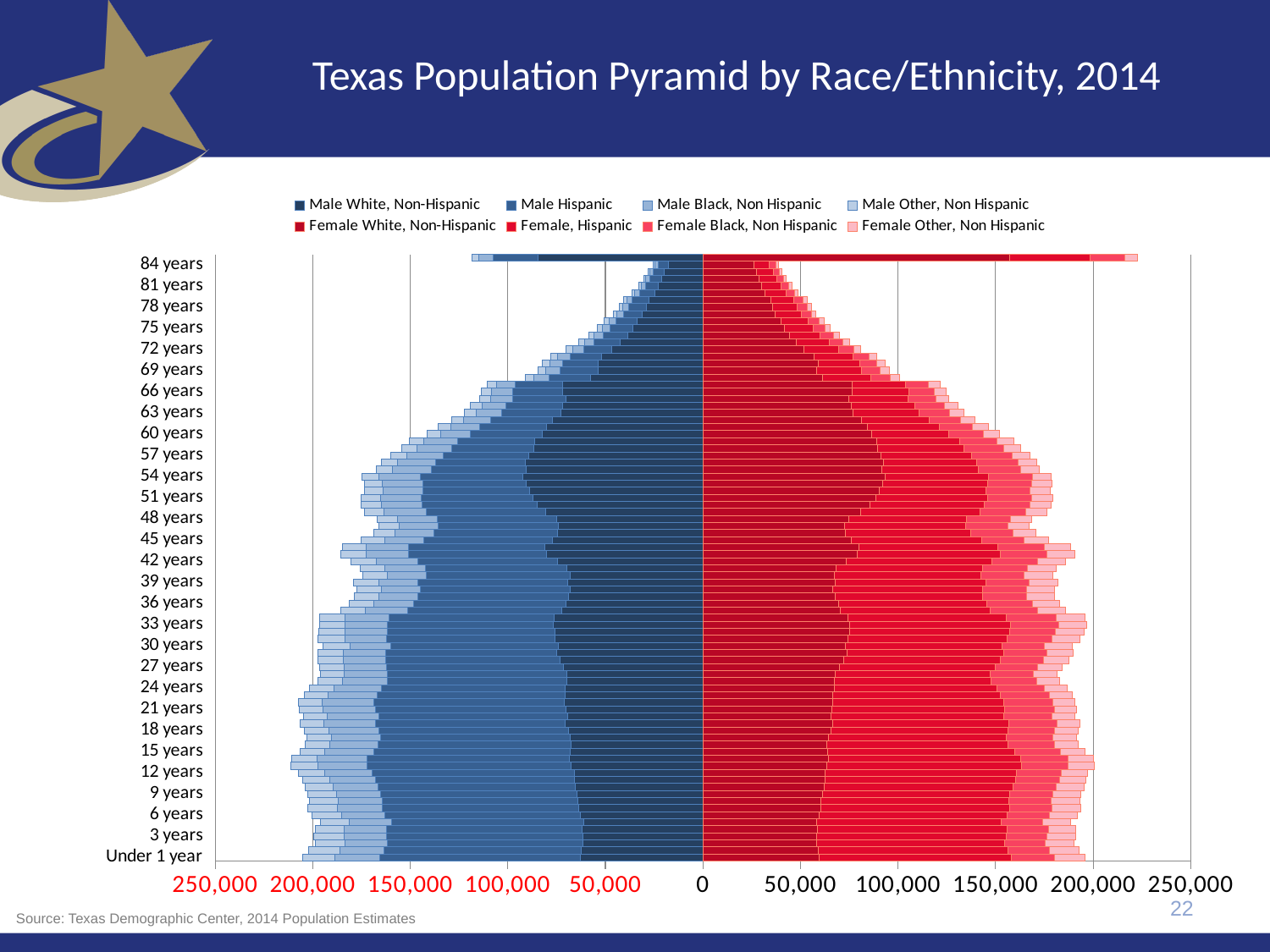
Is the total female value for 72 years greater or less than 100,000? less Is the total male value for 69 years greater or less than 100,000? less Which has the larger total male value, 12 years or 54 years? 12 years What is the title of the chart? Texas Population Pyramid by Race/Ethnicity, 2014 Is the total male value for 81 years greater or less than 50,000? less Which side of the chart shows the male population, left or right? left How many series does the legend list? 8 What kind of chart is shown on the slide? bar chart